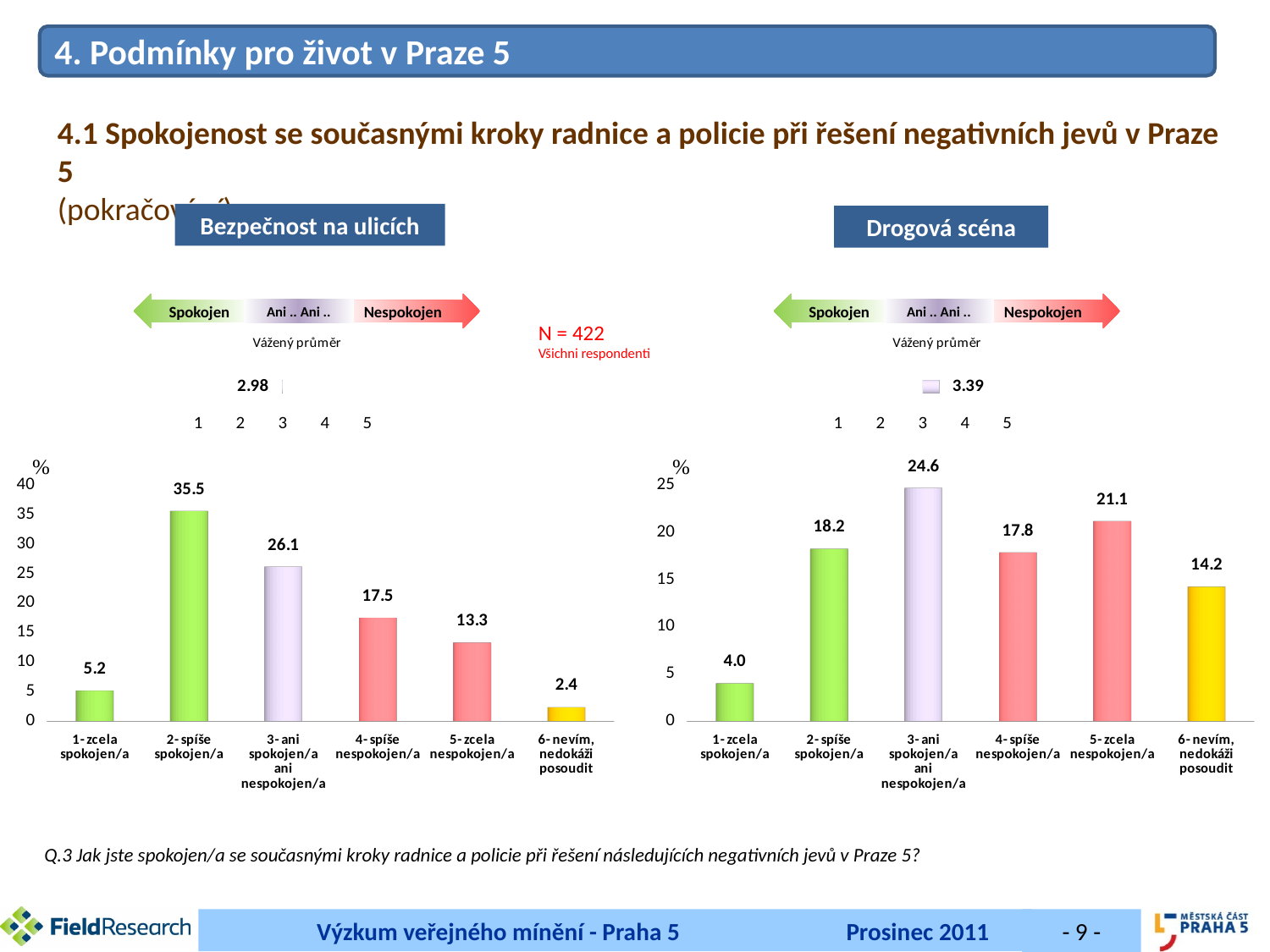
In the 'Drogová scéna' chart, what is the difference between '5- zcela nespokojen/a' and '6- nevím, nedokáži posoudit'? 6.9 In the 'Drogová scéna' chart, which category has the highest value? 3- ani spokojen/a ani nespokojen/a What kind of chart is the 'Drogová scéna' chart? bar chart In the 'Bezpečnost na ulicích' chart, which category has the lowest value? 6- nevím, nedokáži posoudit In the 'Drogová scéna' chart, what is the value for '3- ani spokojen/a ani nespokojen/a'? 24.6 In the 'Drogová scéna' chart, which is larger: '2- spíše spokojen/a' or '5- zcela nespokojen/a'? 5- zcela nespokojen/a In the 'Bezpečnost na ulicích' chart, what is the value for '2- spíše spokojen/a'? 35.5 How many categories are shown in the 'Bezpečnost na ulicích' chart? 6 In the 'Drogová scéna' chart, which category has the lowest value? 1- zcela spokojen/a In the 'Bezpečnost na ulicích' chart, what is the difference between '2- spíše spokojen/a' and '3- ani spokojen/a ani nespokojen/a'? 9.4 In the 'Bezpečnost na ulicích' chart, which is larger: '4- spíše nespokojen/a' or '5- zcela nespokojen/a'? 4- spíše nespokojen/a What is the weighted average (Vážený průměr) shown for the 'Drogová scéna' chart? 3.39